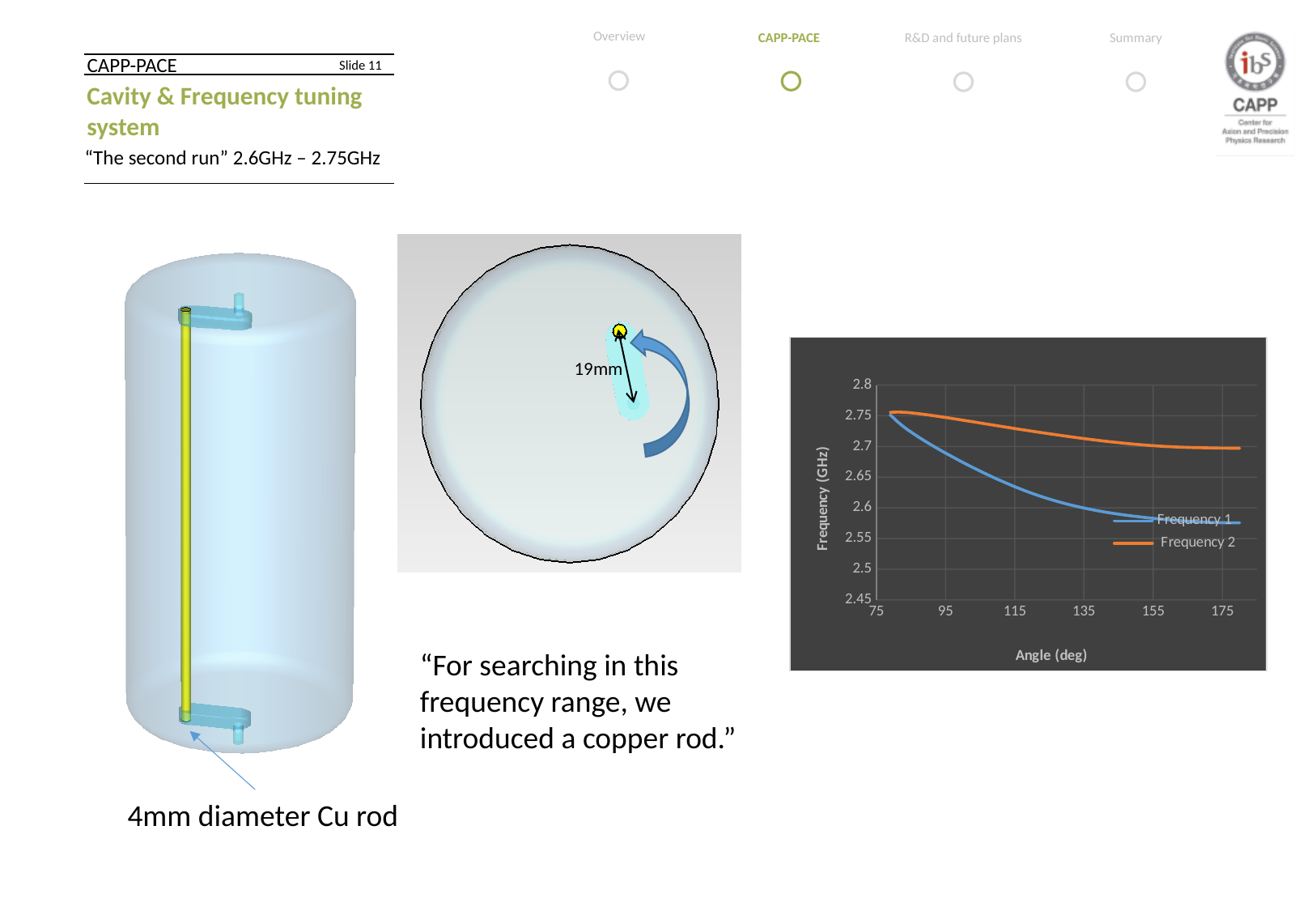
What is the title of the chart's x axis? Angle (deg) Is the value of Frequency 1 at 135 degrees greater or less than 2.65 GHz? less Does the Frequency 2 line rise or fall as the angle increases? fall Is the value of Frequency 2 at 175 degrees greater or less than 2.65 GHz? greater Is the value of Frequency 2 at 95 degrees greater or less than 2.7 GHz? greater Which series shows the larger drop in frequency across the plotted angle range? Frequency 1 At an angle of 175 degrees, which series has the higher frequency, Frequency 1 or Frequency 2? Frequency 2 What kind of chart is shown on the slide? line chart Does the Frequency 1 line rise or fall as the angle increases? fall What are the names of the two series in the chart legend? Frequency 1 and Frequency 2 How many series does the chart's legend list? 2